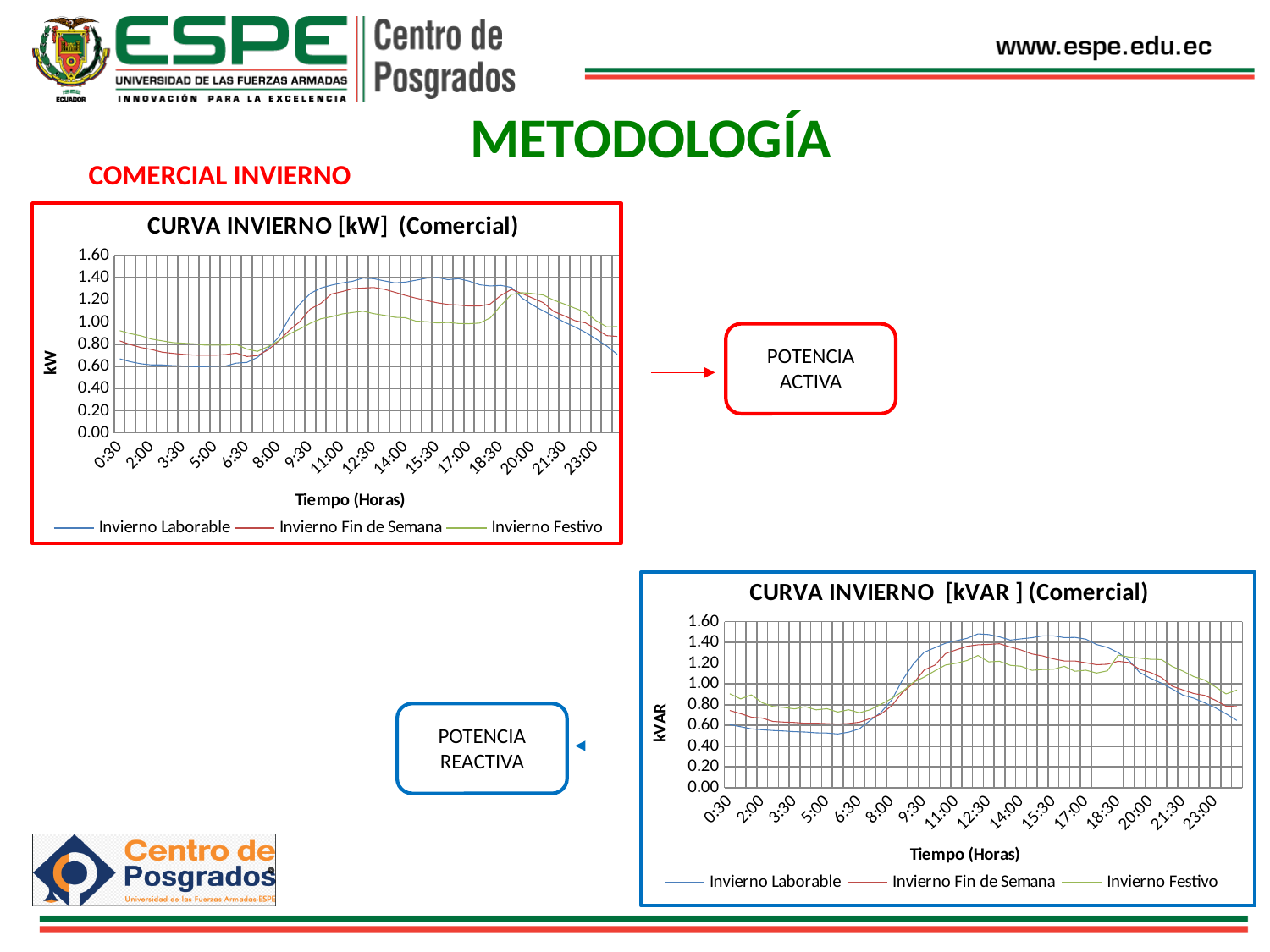
In the 'CURVA INVIERNO [kW] (Comercial)' chart, is the value for Invierno Laborable at 14:00 greater or less than 1.20? greater How many series does the legend of the 'CURVA INVIERNO [kVAR ] (Comercial)' chart list? 3 In the 'CURVA INVIERNO [kW] (Comercial)' chart, which series has the larger value at 12:30, Invierno Laborable or Invierno Festivo? Invierno Laborable In the 'CURVA INVIERNO [kVAR ] (Comercial)' chart, which series has the larger value at 5:00, Invierno Festivo or Invierno Laborable? Invierno Festivo In the 'CURVA INVIERNO [kVAR ] (Comercial)' chart, is the value for Invierno Laborable at 5:00 greater or less than 0.60? less What kind of chart is the 'CURVA INVIERNO [kW] (Comercial)' chart? line chart In the 'CURVA INVIERNO [kW] (Comercial)' chart, is the value for Invierno Festivo at 12:30 greater or less than 1.20? less What is the x-axis title of the 'CURVA INVIERNO [kVAR ] (Comercial)' chart? Tiempo (Horas) In the 'CURVA INVIERNO [kVAR ] (Comercial)' chart, does the Invierno Laborable series rise or fall between 6:30 and 12:30? rise In the 'CURVA INVIERNO [kW] (Comercial)' chart, what are the three series named in the legend? Invierno Laborable, Invierno Fin de Semana, Invierno Festivo